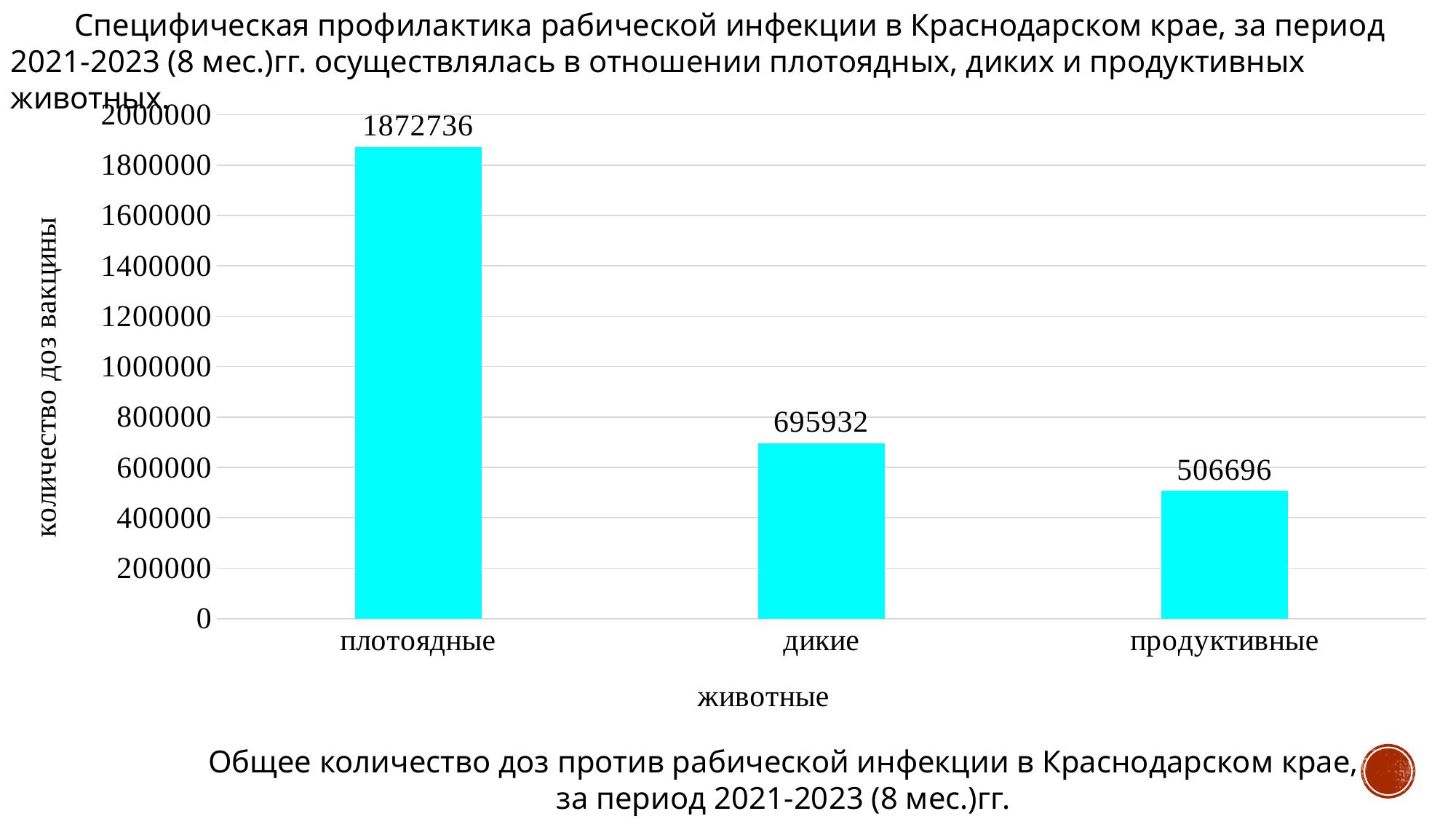
What is the difference between the values for плотоядные and дикие? 1176804 What kind of chart is shown on the slide? bar chart Which category has the lowest value? продуктивные What is the difference between the values for дикие and продуктивные? 189236 What is the value for продуктивные? 506696 What is the label of the vertical axis? количество доз вакцины Is the value for дикие greater or less than 800000? less Which is larger, the value for дикие or the value for продуктивные? дикие What is the value for плотоядные? 1872736 Which category has the highest value? плотоядные How many categories are shown on the x axis? 3 What is the value for дикие? 695932